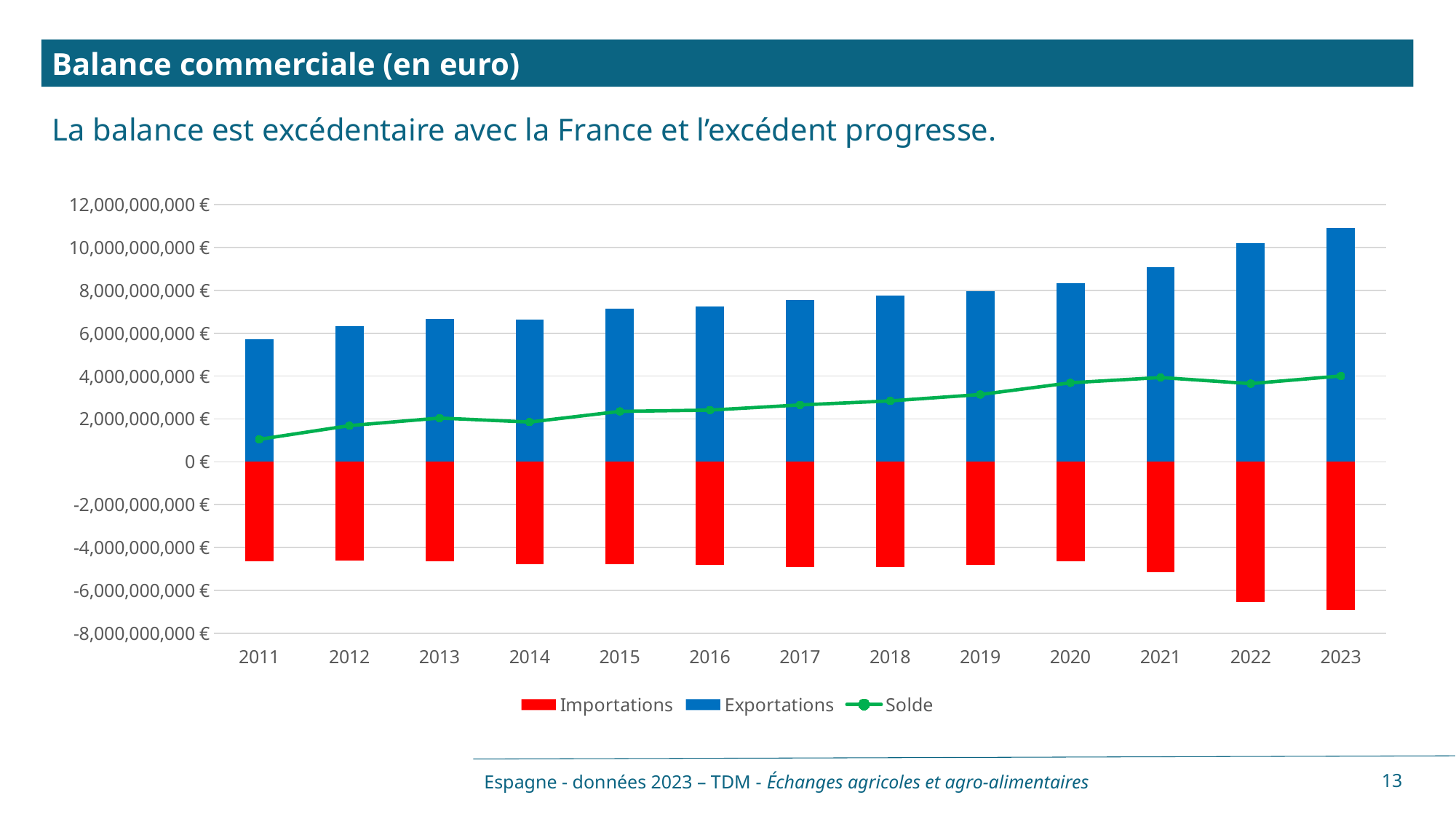
In which year are Exportations highest? 2023 How many series does the legend list? 3 Which is larger, Exportations in 2021 or Exportations in 2022? 2022 Is the value for Exportations in 2023 greater or less than 10,000,000,000 €? greater Is the value for Solde in 2011 greater or less than 2,000,000,000 €? less In which year are Exportations lowest? 2011 In which year is the Solde lowest? 2011 How many years are shown on the x axis? 13 Is the value for Importations in 2023 greater or less than -6,000,000,000 €? less Do Exportations generally rise or fall from 2011 to 2023? rise What kind of chart is shown on the slide? bar chart with a line